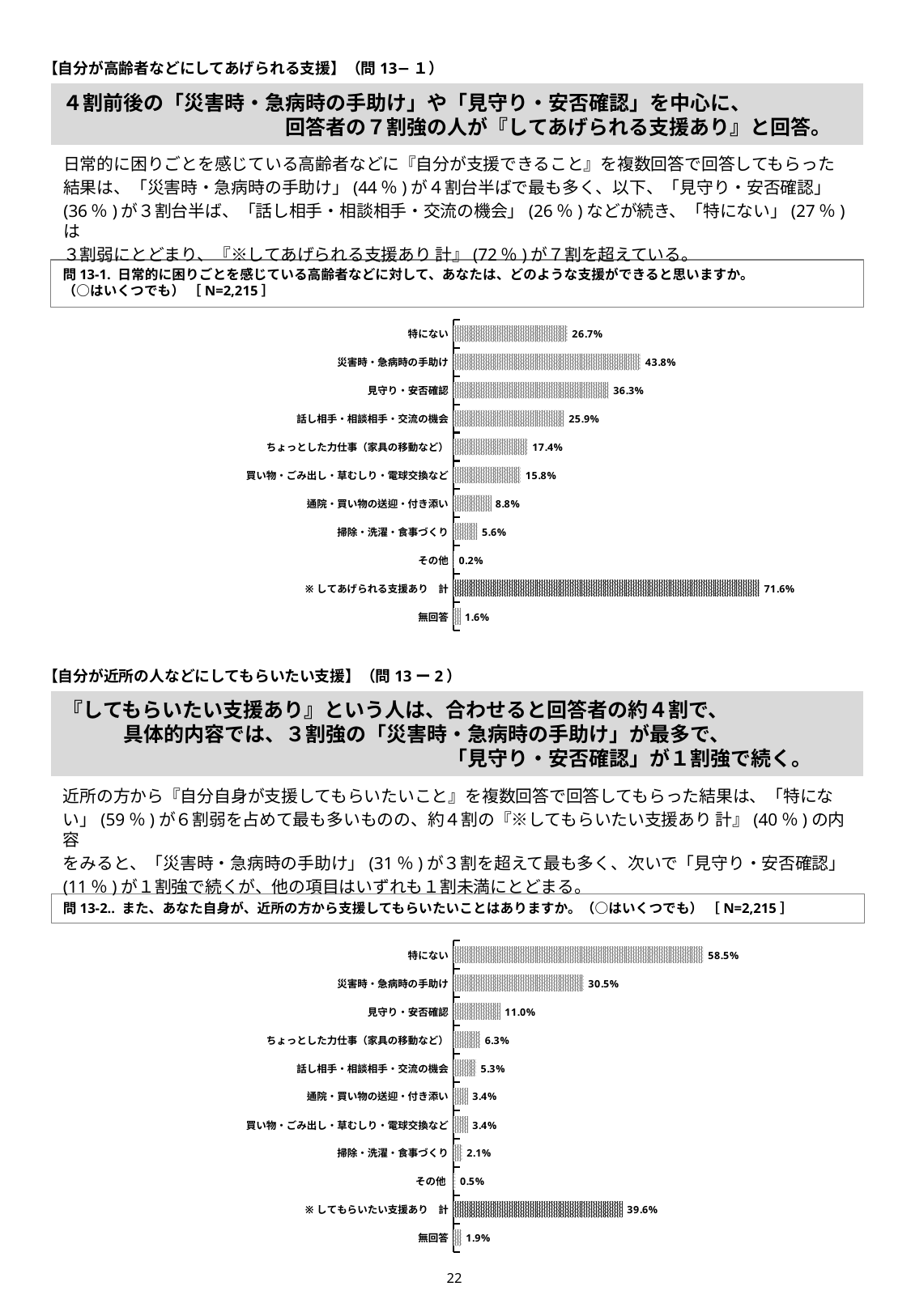
What is the sample size (N) shown for the bottom chart (問13-2)? N=2,215 In the bottom chart (問13-2), which is larger: 災害時・急病時の手助け or 見守り・安否確認? 災害時・急病時の手助け In the bottom chart (問13-2), what is the value for ※してもらいたい支援あり 計? 39.6% In the top chart (問13-1), what is the difference between 特にない and 話し相手・相談相手・交流の機会? 0.8% In the top chart (問13-1), what is the value for 見守り・安否確認? 36.3% What kind of chart is the top chart (問13-1)? Bar chart In the bottom chart (問13-2), which category has the highest value? 特にない In the top chart (問13-1), which category has the lowest value? その他 In the top chart (問13-1), what is the value for 災害時・急病時の手助け? 43.8% In the top chart (問13-1), how many categories are plotted? 11 In the bottom chart (問13-2), what is the value for 特にない? 58.5% In the bottom chart (問13-2), what is the difference between 災害時・急病時の手助け and 見守り・安否確認? 19.5%